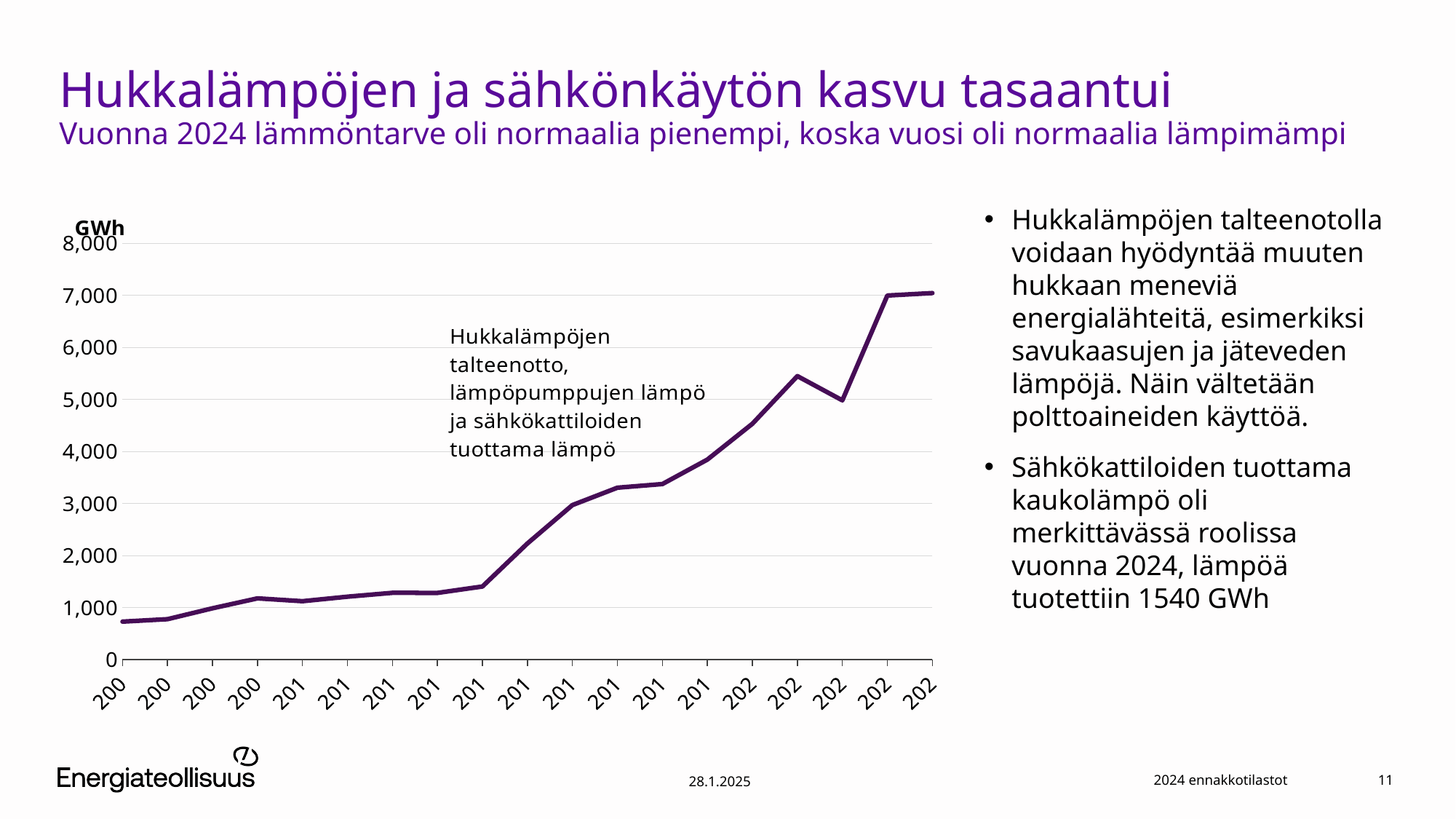
Is the value of the fourth point from the left greater or less than 2,000? less Is the value of the rightmost point larger or smaller than the value of the leftmost point? larger What kind of chart is shown on the slide? line chart Overall, do the values rise or fall from left to right along the x axis? rise What unit is shown on the y axis of the chart? GWh What is the highest value shown on the y axis? 8,000 Is the value of the local peak just before the dip near the right side of the chart greater or less than 5,000? greater Is the value of the point at the dip near the right side of the chart greater or less than 4,000? greater Which point on the line has the highest value, the leftmost or the rightmost? the rightmost How many data points are plotted on the line? 19